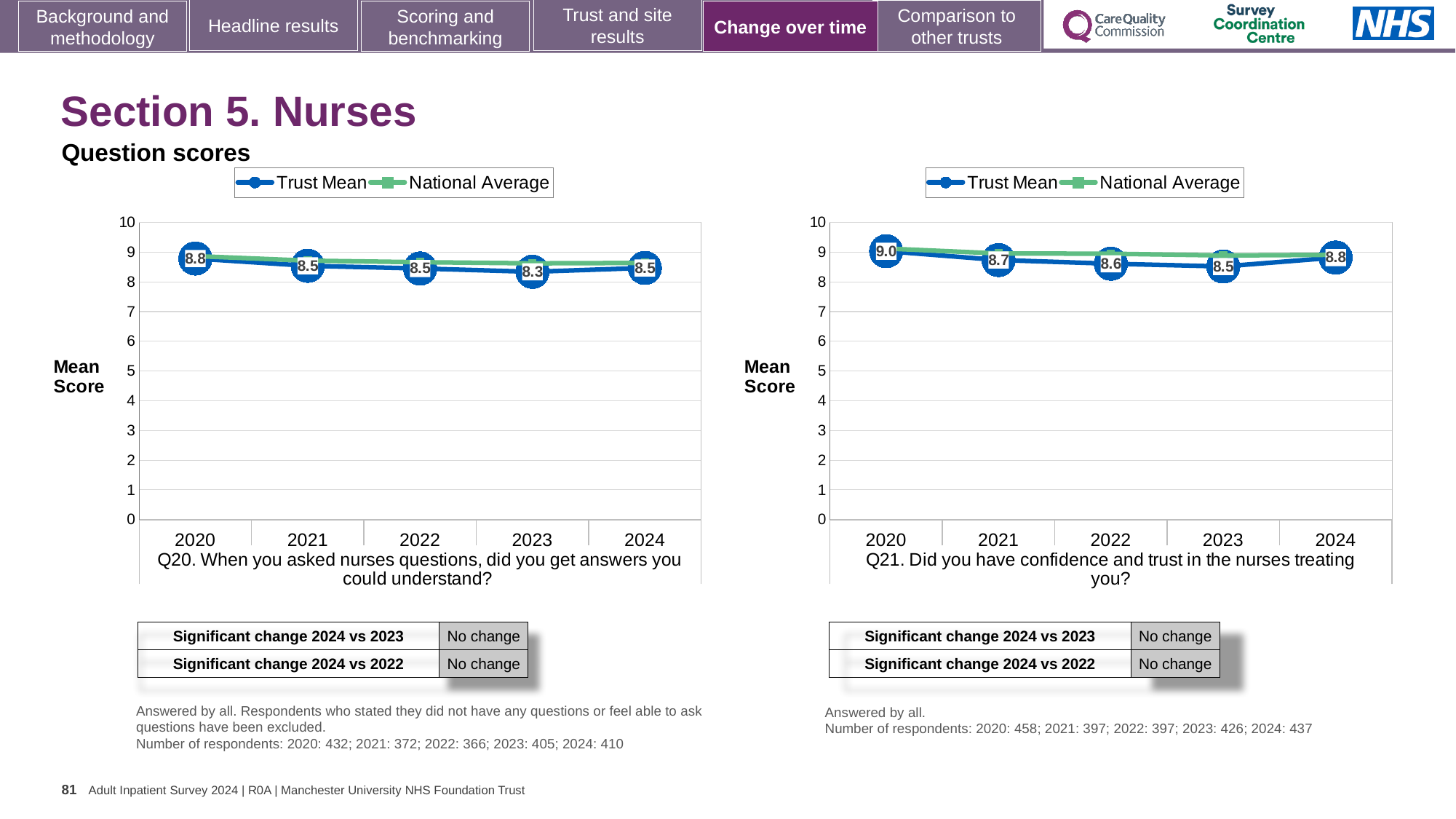
In the Q21 chart (right), what is the difference between the Trust Mean scores for 2020 and 2023? 0.5 In the Q21 chart (right), is the National Average for 2024 greater or less than 8? greater In the Q21 chart (right), does the Trust Mean score rise or fall from 2020 to 2023? Fall In the Q20 chart (left), what is the Trust Mean score for 2020? 8.8 What type of chart is used for Q20 (left)? Line chart In the Q21 chart (right), which year has the highest Trust Mean score? 2020 In the Q21 chart (right), what is the Trust Mean score for 2024? 8.8 In the Q20 chart (left), is the Trust Mean score for 2020 or 2024 higher? 2020 In the Q20 chart (left), which year has the lowest Trust Mean score? 2023 In the Q20 chart (left), what is the Trust Mean score for 2023? 8.3 How many series does the legend of the Q21 chart (right) list? 2 How many years are shown on the x axis of the Q20 chart (left)? 5